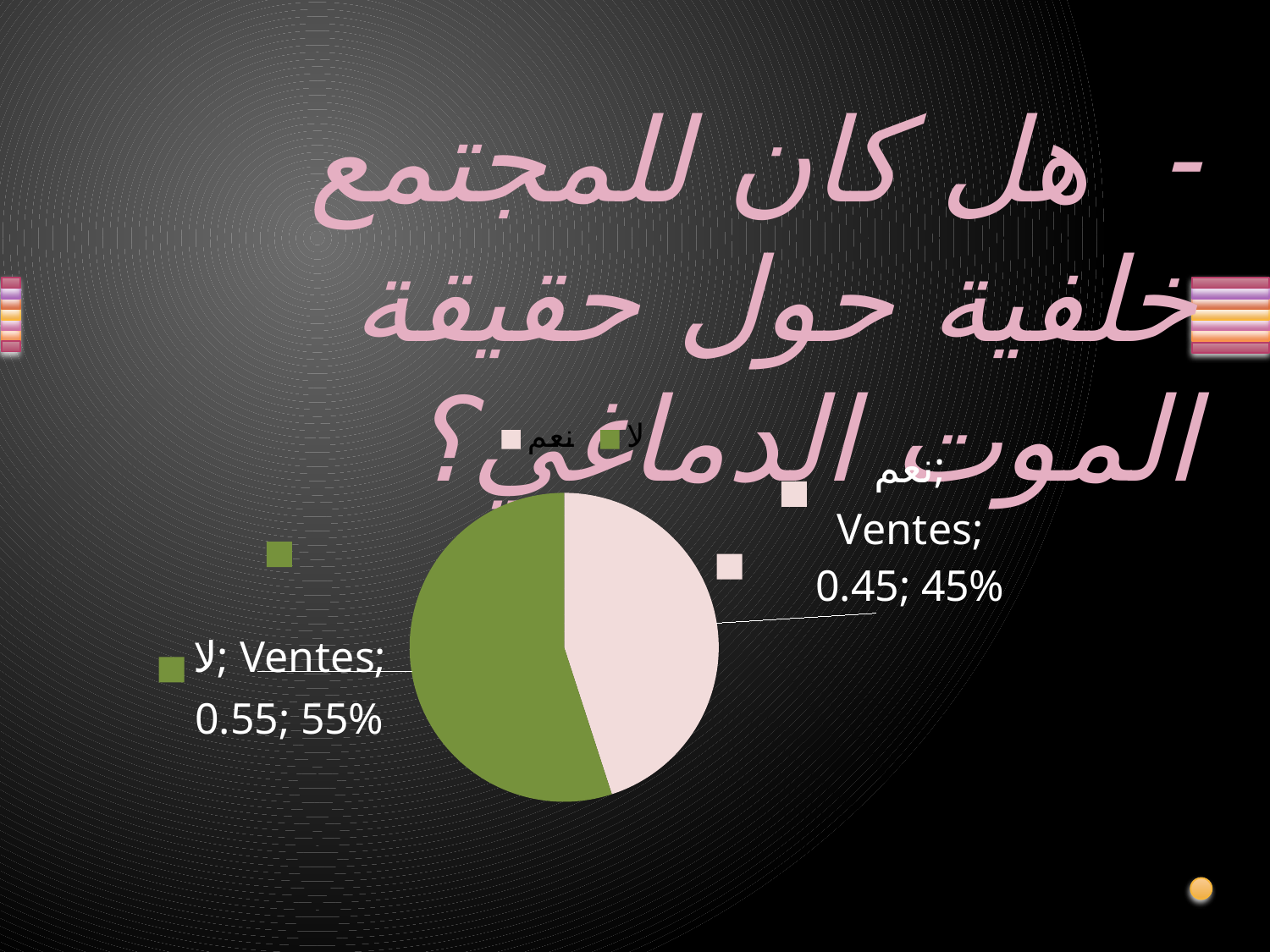
Which slice is the smallest in the pie chart? نعم What is the difference in percentage points between the "لا" slice and the "نعم" slice? 10% What kind of chart is shown on the slide? pie chart What colour is the "لا" slice of the pie chart? green What percentage of the pie does the "لا" slice represent? 55% Which slice is larger, "نعم" or "لا"? لا What series name appears in the data labels of the pie chart? Ventes Which slice is the largest in the pie chart? لا What value is printed for the "لا" slice in the data label? 0.55 How many slices does the pie chart have? 2 What percentage of the pie does the "نعم" slice represent? 45% What value is printed for the "نعم" slice in the data label? 0.45